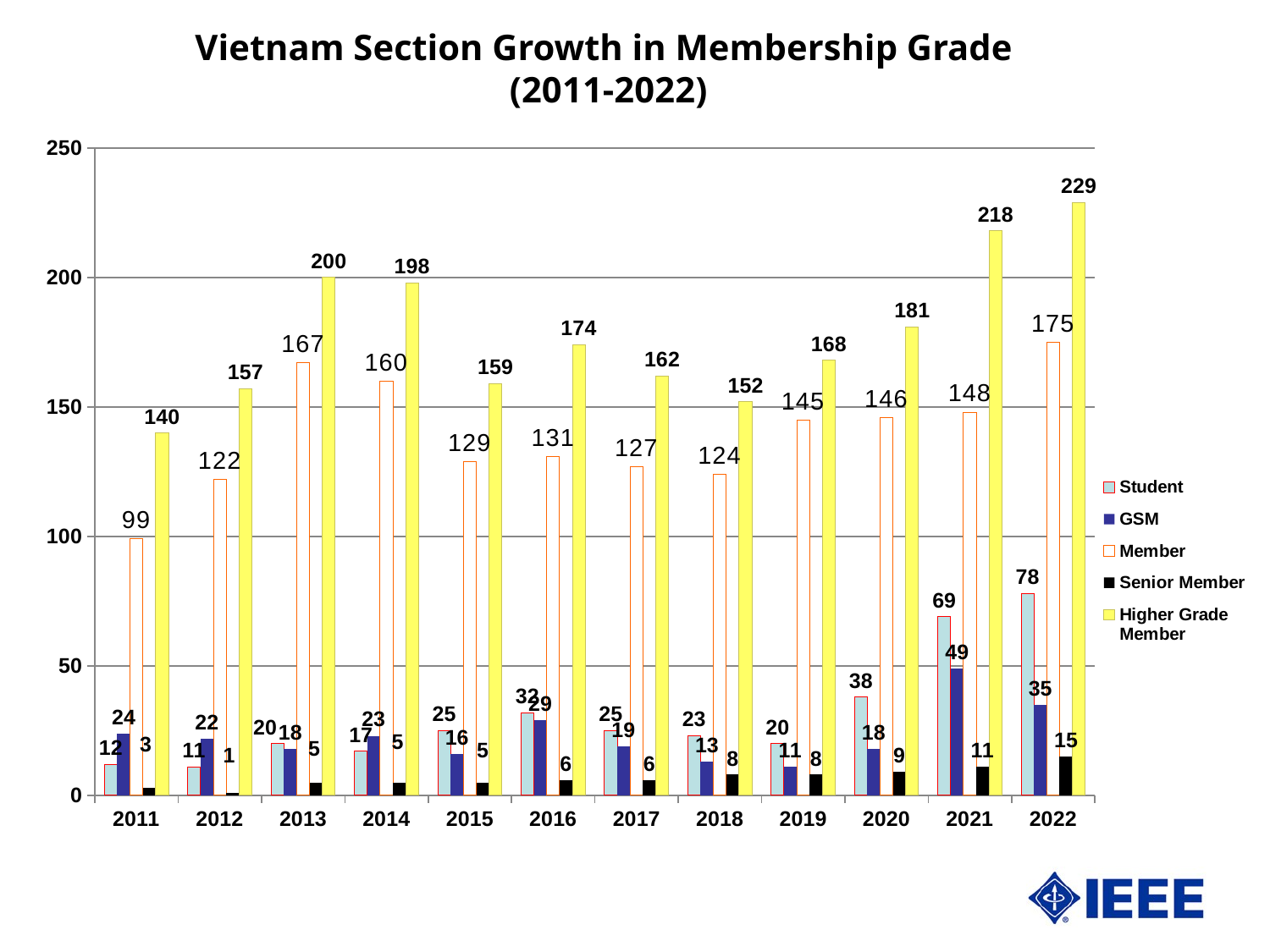
In which year is the Higher Grade Member value highest? 2022 How many series does the legend list? 5 Which series is shown in yellow in the legend? Higher Grade Member How many years are shown on the x axis? 12 What is the value for Member in 2013? 167 What is the difference between the Higher Grade Member values in 2022 and 2011? 89 What is the value for Senior Member in 2012? 1 What is the value for Higher Grade Member in 2022? 229 What is the value for Student in 2021? 69 In which year is the Member value lowest? 2011 Which is larger in 2016, the Student value or the GSM value? Student What kind of chart is shown on the slide? Bar chart